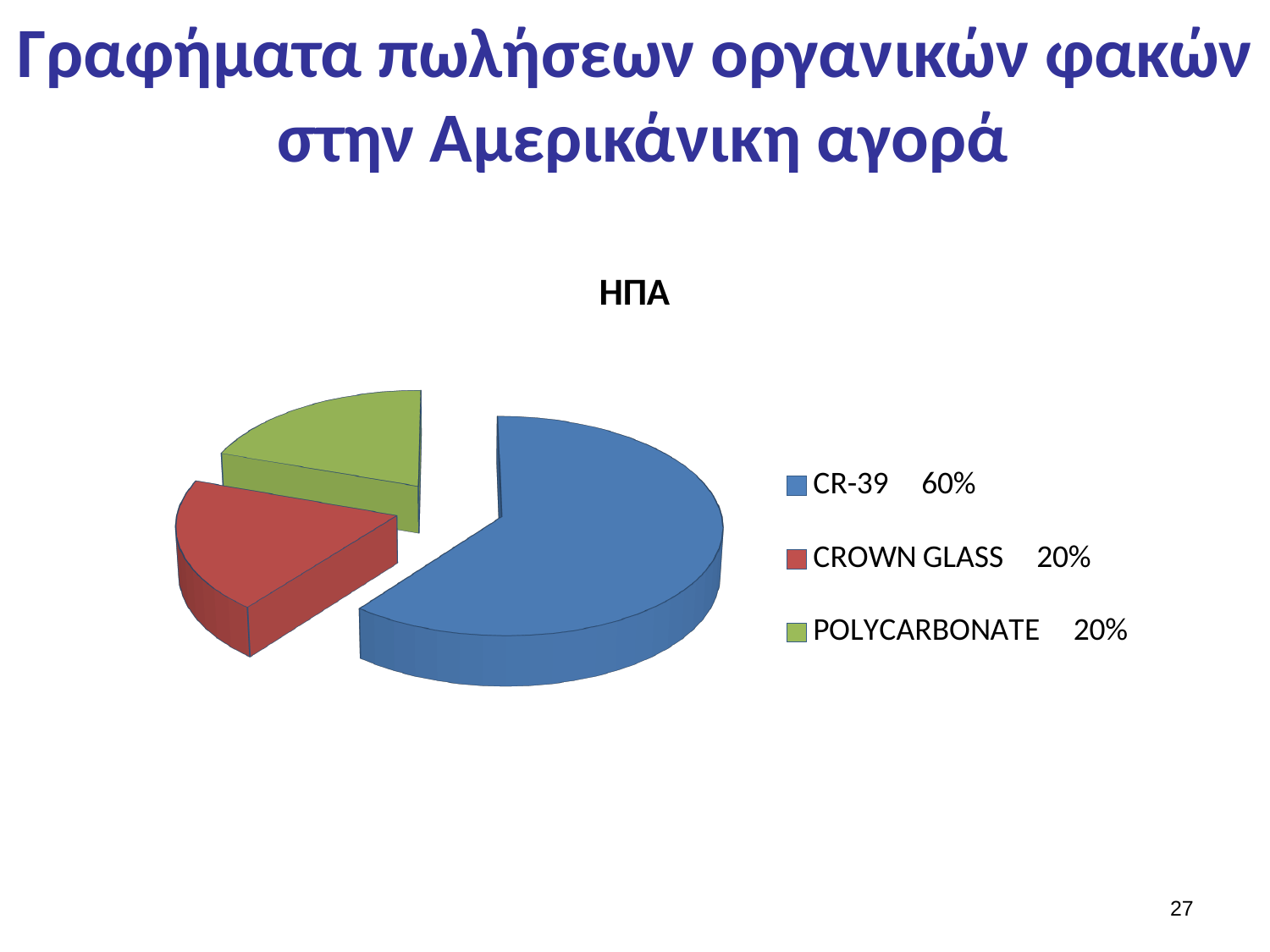
Which category has the largest slice of the pie? CR-39 What colour is the CR-39 slice? blue Which is larger, the share of CR-39 or the share of POLYCARBONATE? CR-39 What is the title of the chart? ΗΠΑ How many entries does the legend list? 3 What is the combined share of CROWN GLASS and POLYCARBONATE? 40% What kind of chart is shown on the slide? pie chart What share of the pie does POLYCARBONATE have? 20% What share of the pie does CROWN GLASS have? 20% How many slices does the pie chart have? 3 What is the difference between the share of CR-39 and the share of CROWN GLASS? 40% What share of the pie does CR-39 have? 60%